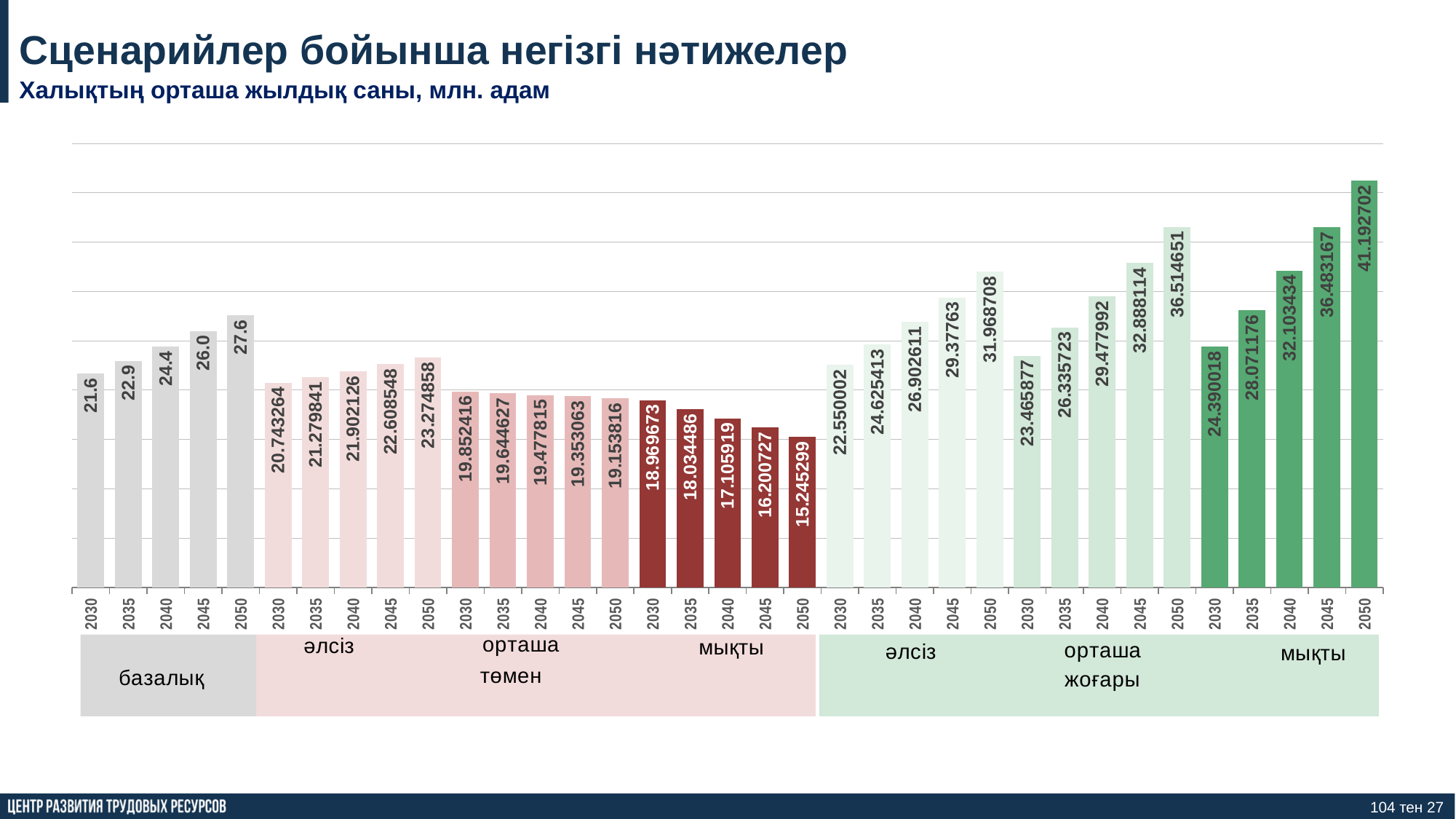
What is the value for 2030 in the төмен әлсіз group? 20.743264 What type of chart is shown on the slide? bar chart How many bars are plotted on the chart? 35 What is the difference between the 2050 and 2030 values in the базалық group? 6.0 What is the value for 2050 in the базалық group? 27.6 Which bar has the highest value on the chart? 2050 in жоғары мықты (41.192702) Which is larger: the 2050 value in жоғары орташа or the 2050 value in жоғары әлсіз? жоғары орташа (36.514651) Do the values in the жоғары әлсіз group rise or fall from 2030 to 2050? rise Do the values in the төмен мықты group rise or fall from 2030 to 2050? fall What is the value for 2050 in the жоғары мықты group? 41.192702 Which bar has the lowest value on the chart? 2050 in төмен мықты (15.245299) What is the value for 2040 in the төмен мықты group? 17.105919